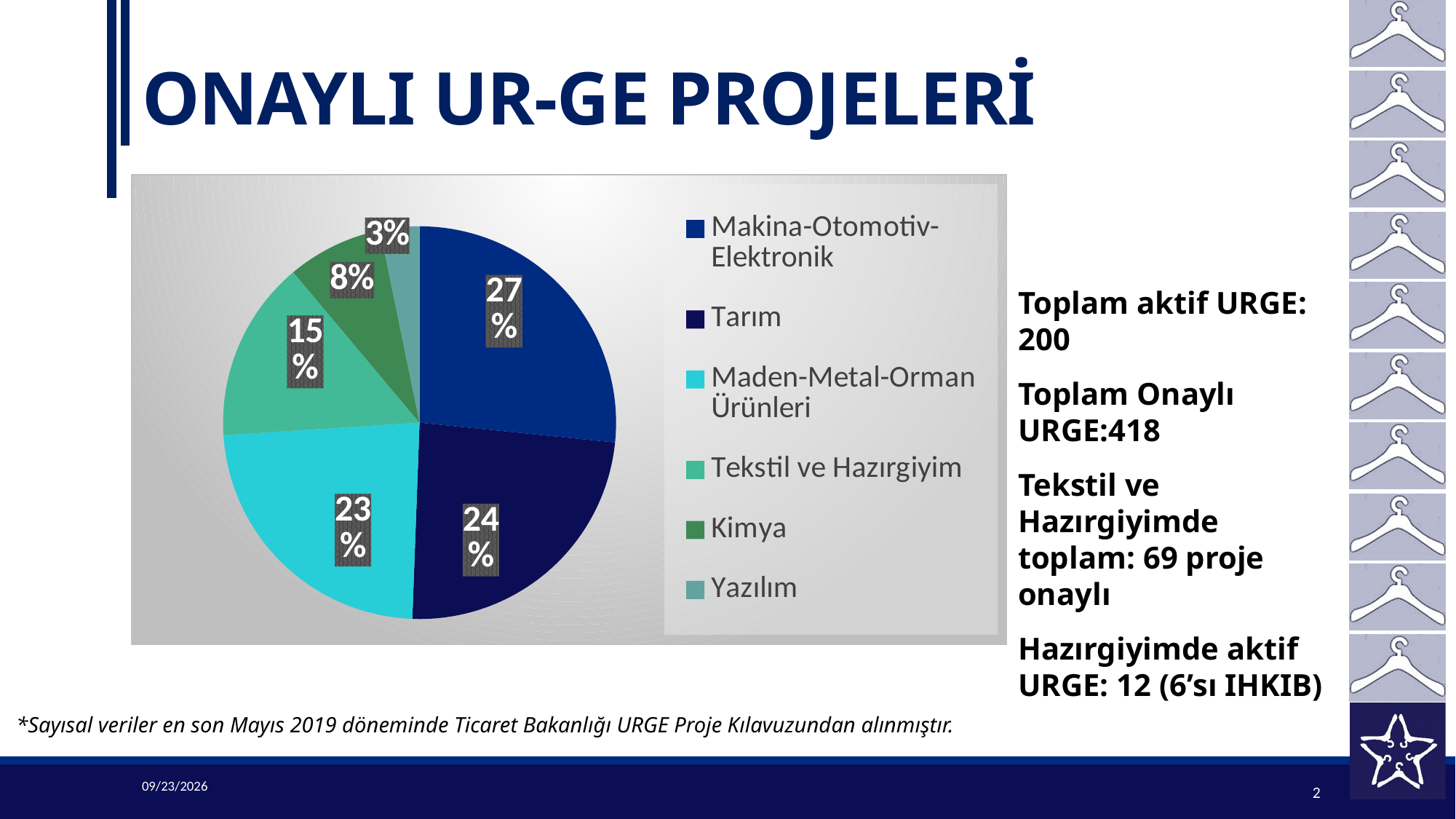
What kind of chart is shown on the slide? pie chart What share of the pie does Yazılım have? 3% What share of the pie does Kimya have? 8% How many categories does the pie chart legend list? 6 What share of the pie does Makina-Otomotiv-Elektronik have? 27% Which category has the smallest slice of the pie? Yazılım Which category has the largest slice of the pie? Makina-Otomotiv-Elektronik Which is larger, the slice for Tarım or the slice for Tekstil ve Hazırgiyim? Tarım What is the difference in percentage points between Tekstil ve Hazırgiyim and Kimya? 7